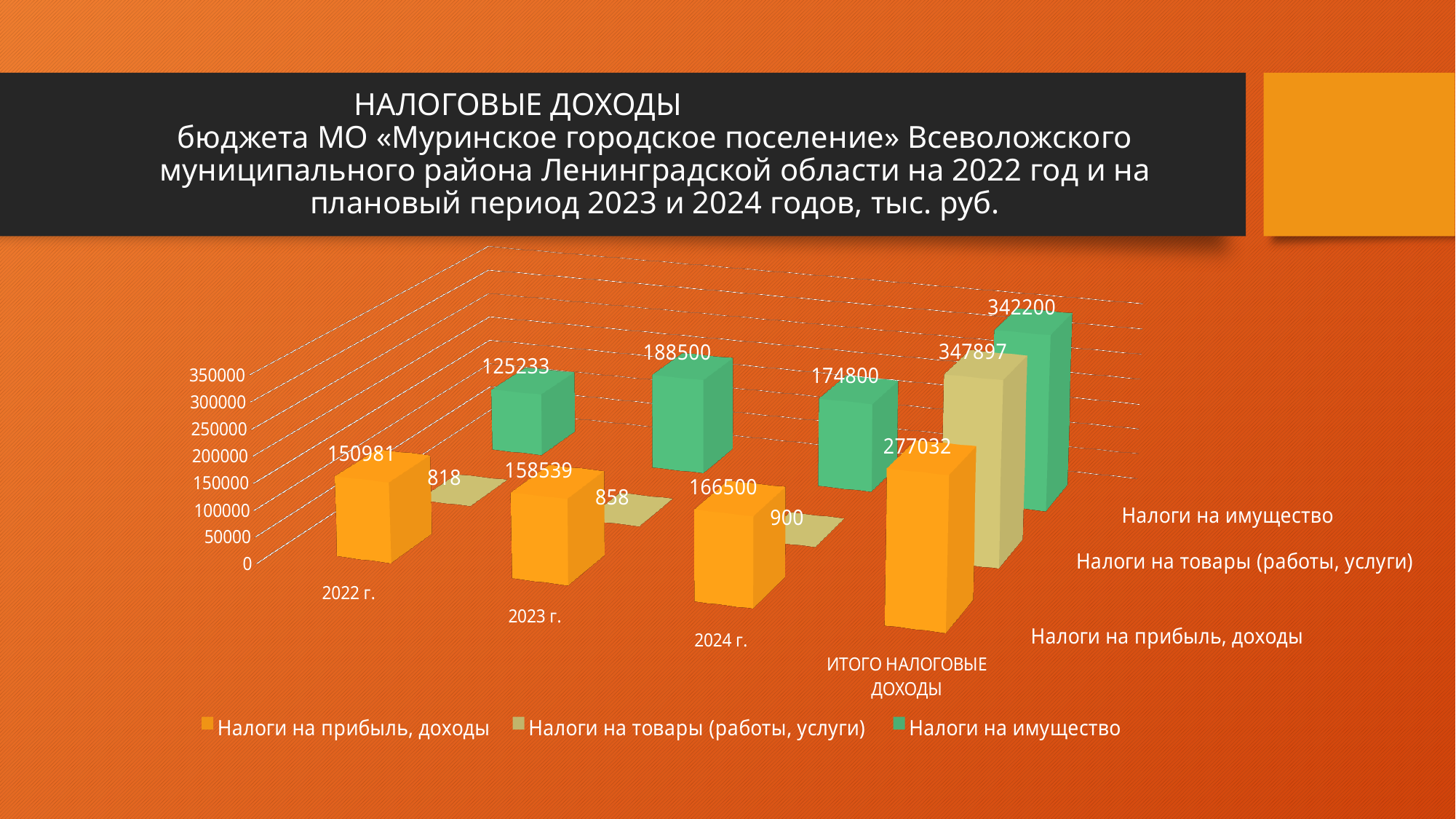
Which is larger: Налоги на имущество for 2022 г. or Налоги на прибыль, доходы for 2022 г.? Налоги на прибыль, доходы for 2022 г. Does the value of Налоги на прибыль, доходы rise or fall from 2022 г. to 2024 г.? rise What is the value of Налоги на имущество for 2023 г.? 188500 What is the value of Налоги на товары (работы, услуги) for 2024 г.? 900 Which year has the highest value for Налоги на имущество among 2022 г., 2023 г. and 2024 г.? 2023 г. How many series does the legend list? 3 What type of chart is shown on the slide? bar chart Which year has the lowest value for Налоги на прибыль, доходы among 2022 г., 2023 г. and 2024 г.? 2022 г. What is the value of Налоги на прибыль, доходы for 2022 г.? 150981 What is the value of Налоги на имущество for 2024 г.? 174800 What is the difference between Налоги на прибыль, доходы for 2024 г. and 2023 г.? 7961 What is the value of the orange series (Налоги на прибыль, доходы) for ИТОГО НАЛОГОВЫЕ ДОХОДЫ? 277032